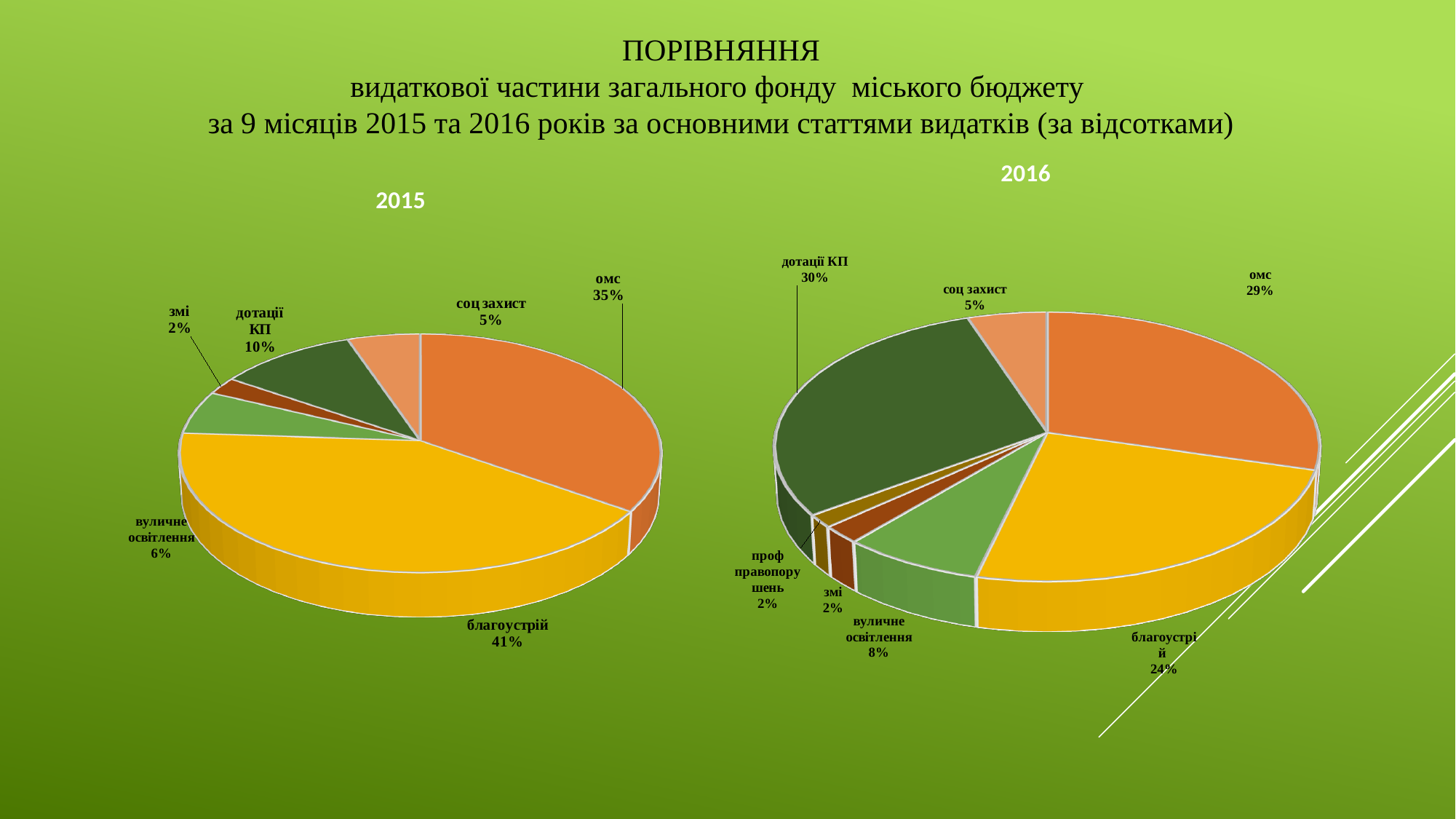
In the 2015 pie chart, which category has the largest share? благоустрій In the 2016 pie chart, which is larger, омс or благоустрій? омс What type of chart is used for the 2015 data? Pie chart In the 2015 pie chart, what share does омс have? 35% In the 2016 pie chart, which category has the largest share? дотації КП In the 2015 pie chart, which category has the smallest share? змі In the 2016 pie chart, what share does дотації КП have? 30% In the 2016 pie chart, what share does вуличне освітлення have? 8% How many slices does the 2015 pie chart have? 6 What is the difference between the благоустрій share in the 2015 chart and in the 2016 chart? 17 percentage points In the 2015 pie chart, what share does благоустрій have? 41% How many slices does the 2016 pie chart have? 7